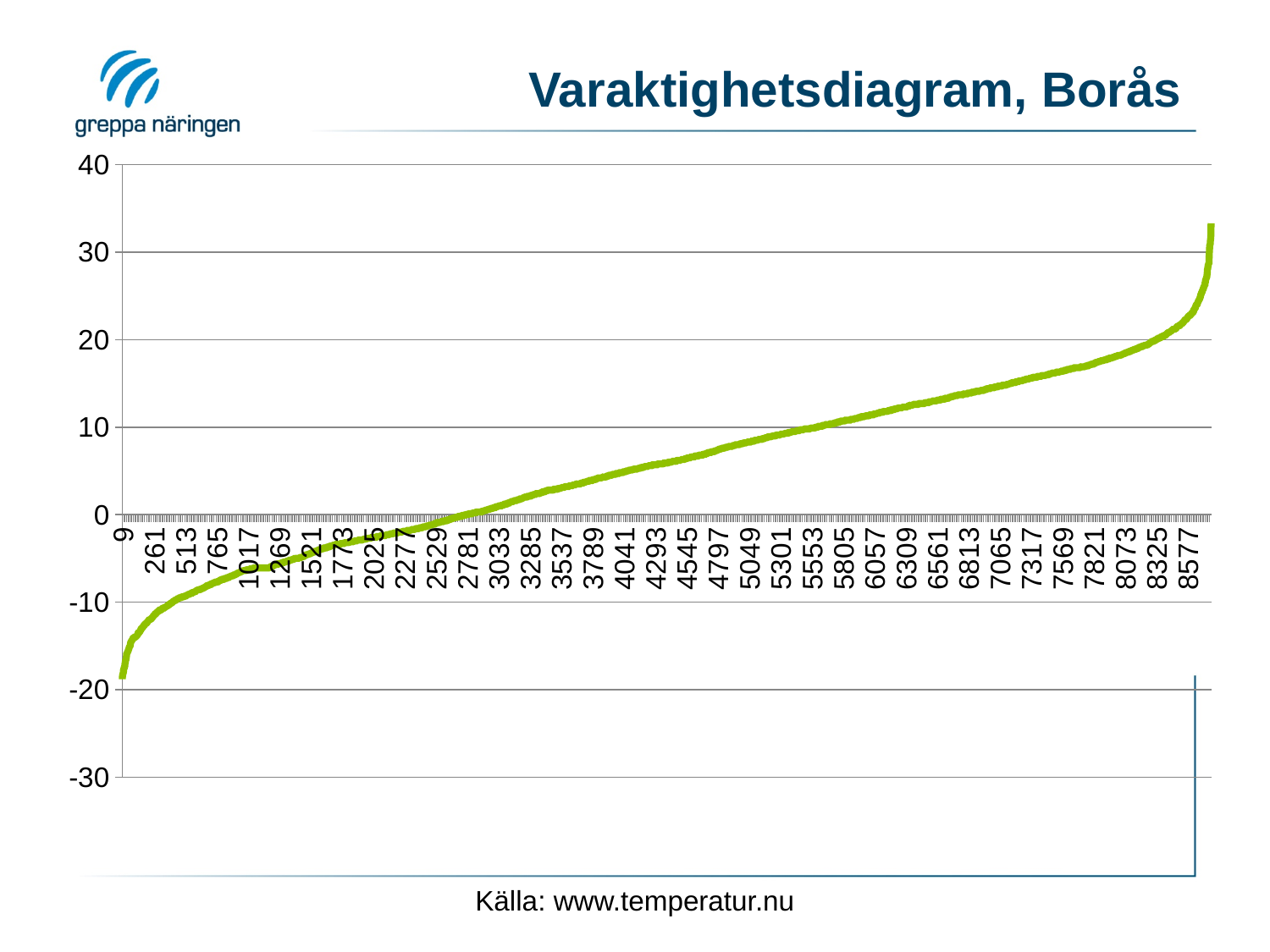
Do the values rise or fall along the x axis? rise Is the value at x = 1017 greater or less than 0? less Is the value at x = 8577 greater or less than 20? greater What is the title of the chart? Varaktighetsdiagram, Borås Is the highest value on the curve greater or less than 30? greater What kind of chart is shown on the slide? line chart What source is cited below the chart? www.temperatur.nu